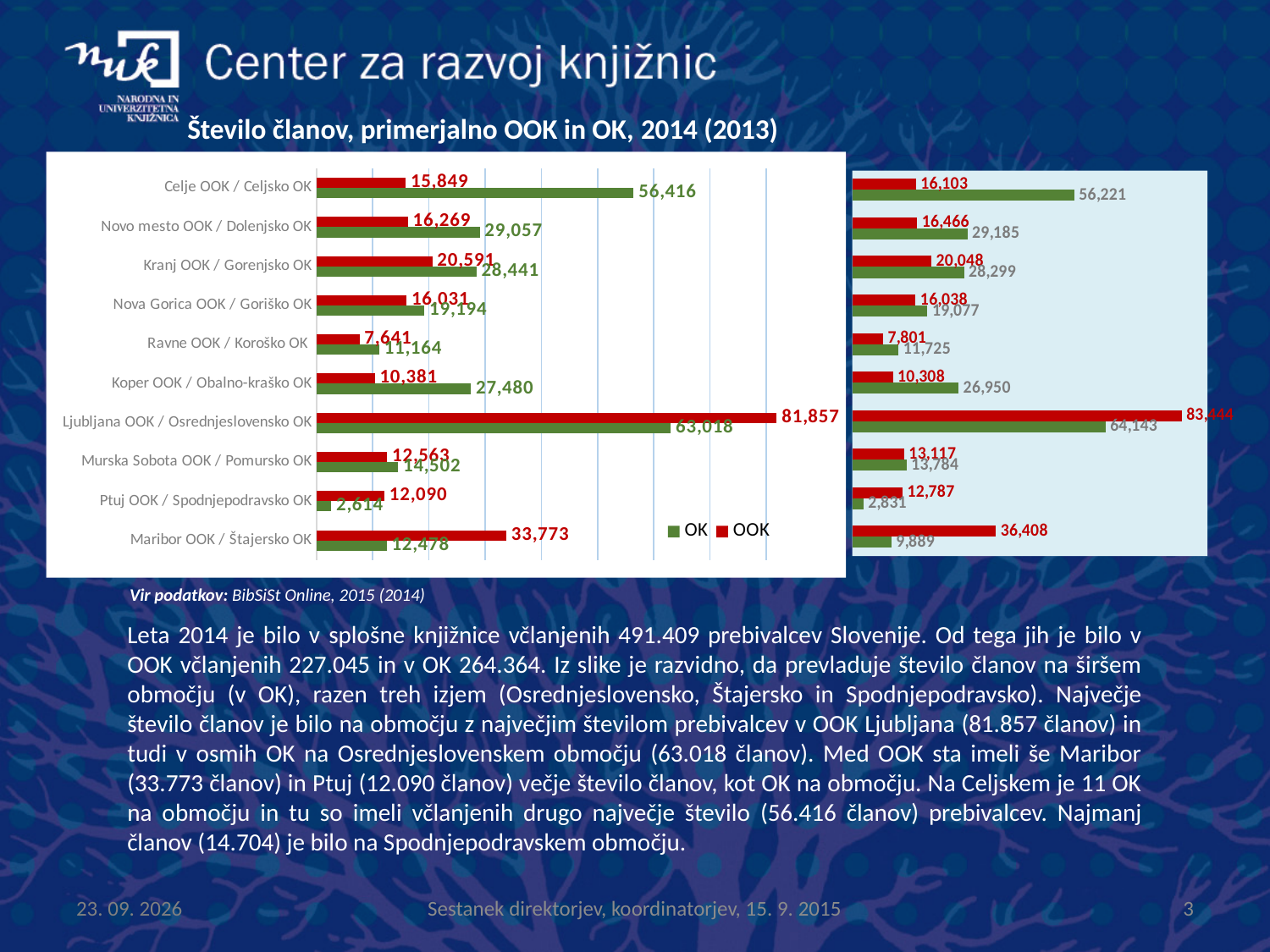
In the left chart, which has the larger OOK value, Kranj OOK / Gorenjsko OK or Novo mesto OOK / Dolenjsko OK? Kranj OOK / Gorenjsko OK In the left chart, what is the difference between the OOK and OK values for Ljubljana OOK / Osrednjeslovensko OK? 18,839 What type of chart is the left chart? Bar chart How many series does the legend of the left chart list? 2 In the left chart, which category has the highest OOK value? Ljubljana OOK / Osrednjeslovensko OK How many categories are shown in the left chart? 10 In the left chart, which category has the lowest OK value? Ptuj OOK / Spodnjepodravsko OK In the left chart, what is the OK value for Celje OOK / Celjsko OK? 56,416 In the left chart, what is the OOK value for Ljubljana OOK / Osrednjeslovensko OK? 81,857 In the left chart, what is the OK value for Koper OOK / Obalno-kraško OK? 27,480 In the left chart, for Maribor OOK / Štajersko OK, which series has the larger value, OK or OOK? OOK In the left chart, what is the difference between the OK and OOK values for Celje OOK / Celjsko OK? 40,567